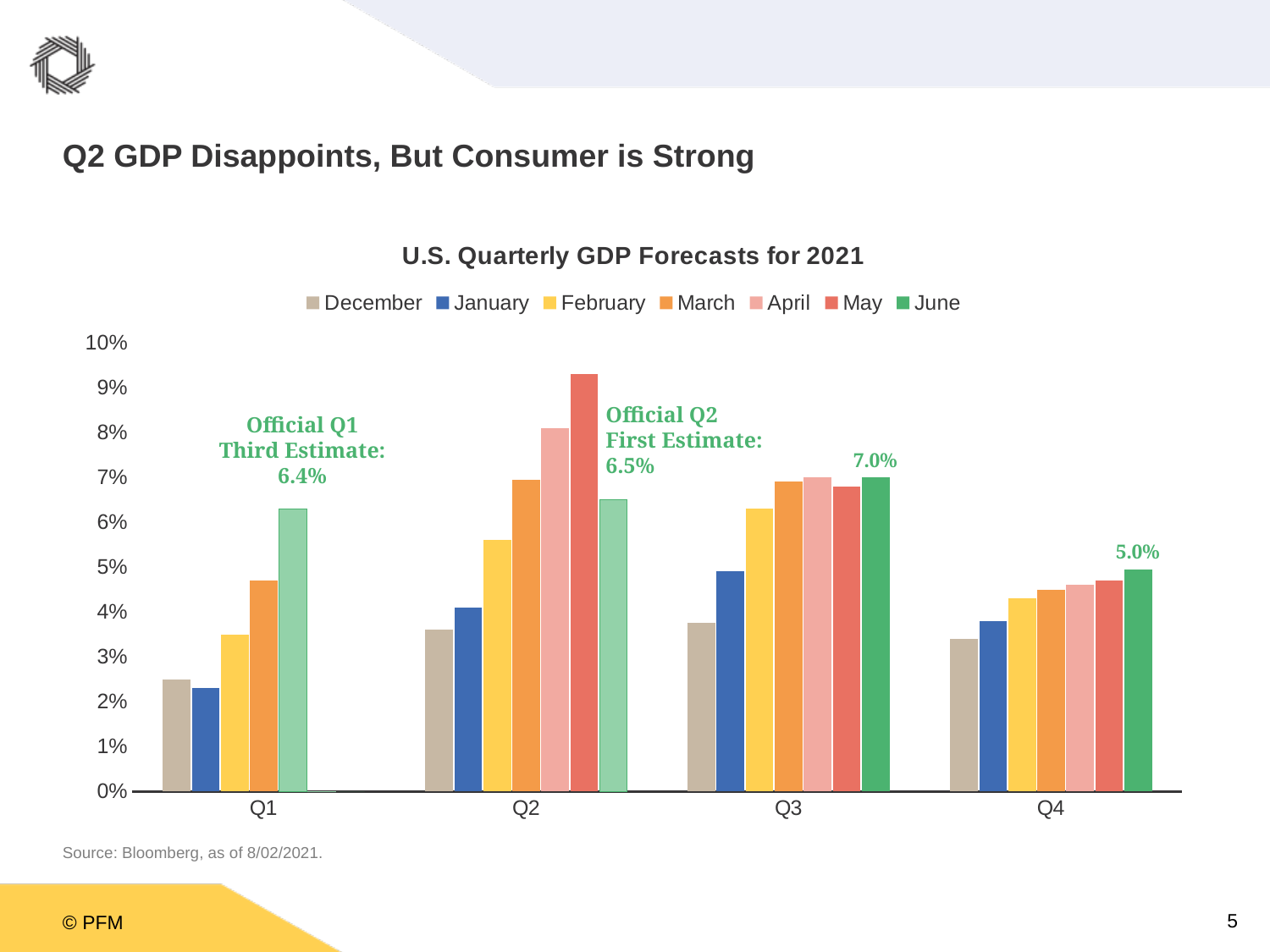
What is the June forecast value for Q4? 5.0% Is the May forecast for Q2 greater or less than 9%? greater Which is larger, the April forecast for Q2 or the April forecast for Q3? Q2 What is the Official Q2 First Estimate shown on the chart? 6.5% How many quarters are shown on the x axis? 4 What is the difference between the June values for Q3 and Q4? 2.0% What kind of chart is shown on the slide? bar chart Is the December forecast for Q1 greater or less than 3%? less What is the Official Q1 Third Estimate shown on the chart? 6.4% What is the June forecast value for Q3? 7.0% Which quarter has the highest May forecast? Q2 How many series does the legend list? 7